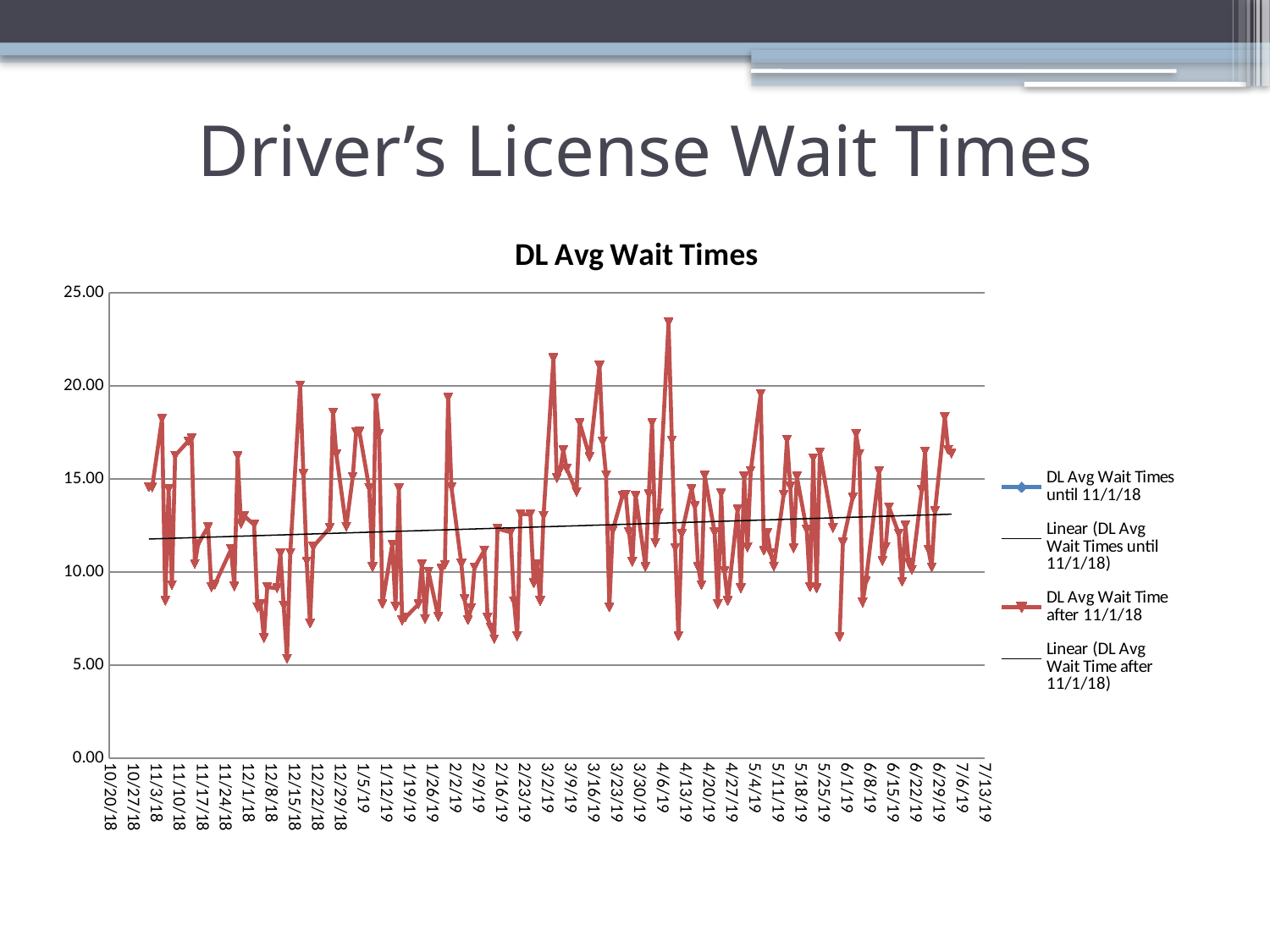
What kind of chart is shown on the slide? line chart Is the highest point of the DL Avg Wait Time after 11/1/18 series greater or less than 20? greater Is the last plotted point of the DL Avg Wait Time after 11/1/18 series (near 7/6/19) greater or less than 15? greater Is the lowest point of the DL Avg Wait Time after 11/1/18 series greater or less than 10? less Does the linear trend line for DL Avg Wait Time after 11/1/18 rise or fall from left to right? rise How many entries does the chart legend list? 4 What is the title of the chart? DL Avg Wait Times What is the highest value shown on the vertical axis? 25.00 How many date labels are shown along the horizontal axis? 39